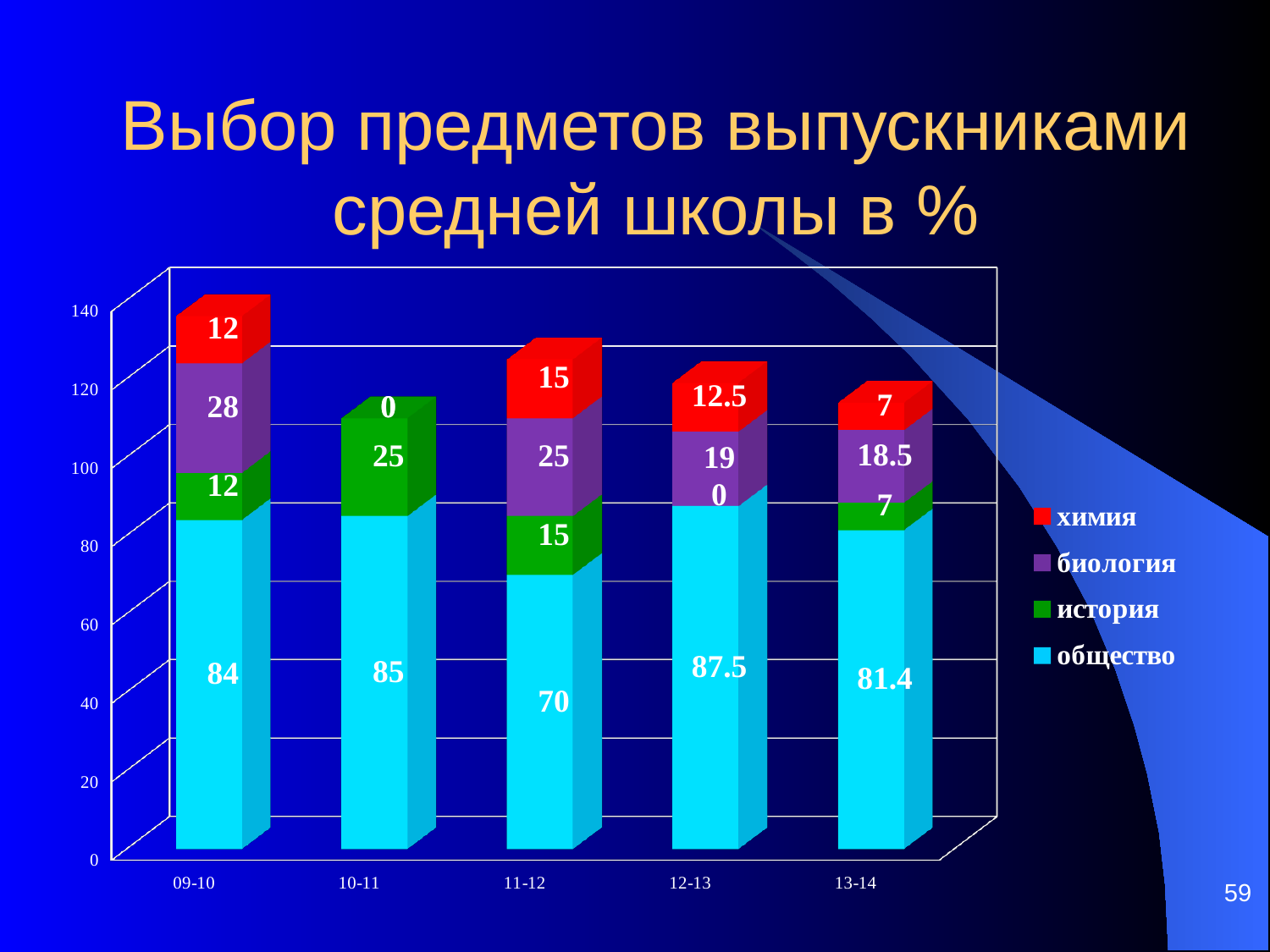
In which category is the value for общество the highest? 12-13 What kind of chart is shown on the slide? stacked bar chart What is the value for химия in 13-14? 7 How many categories are shown on the x axis? 5 What is the value for история in 11-12? 15 In which category is the value for общество the lowest? 11-12 What is the difference between the химия values for 11-12 and 12-13? 2.5 What is the value for общество in 12-13? 87.5 Which is larger, the биология value for 11-12 or for 13-14? 11-12 What is the value for биология in 09-10? 28 How many series does the legend list? 4 What is the total of the stacked bar for 09-10? 136